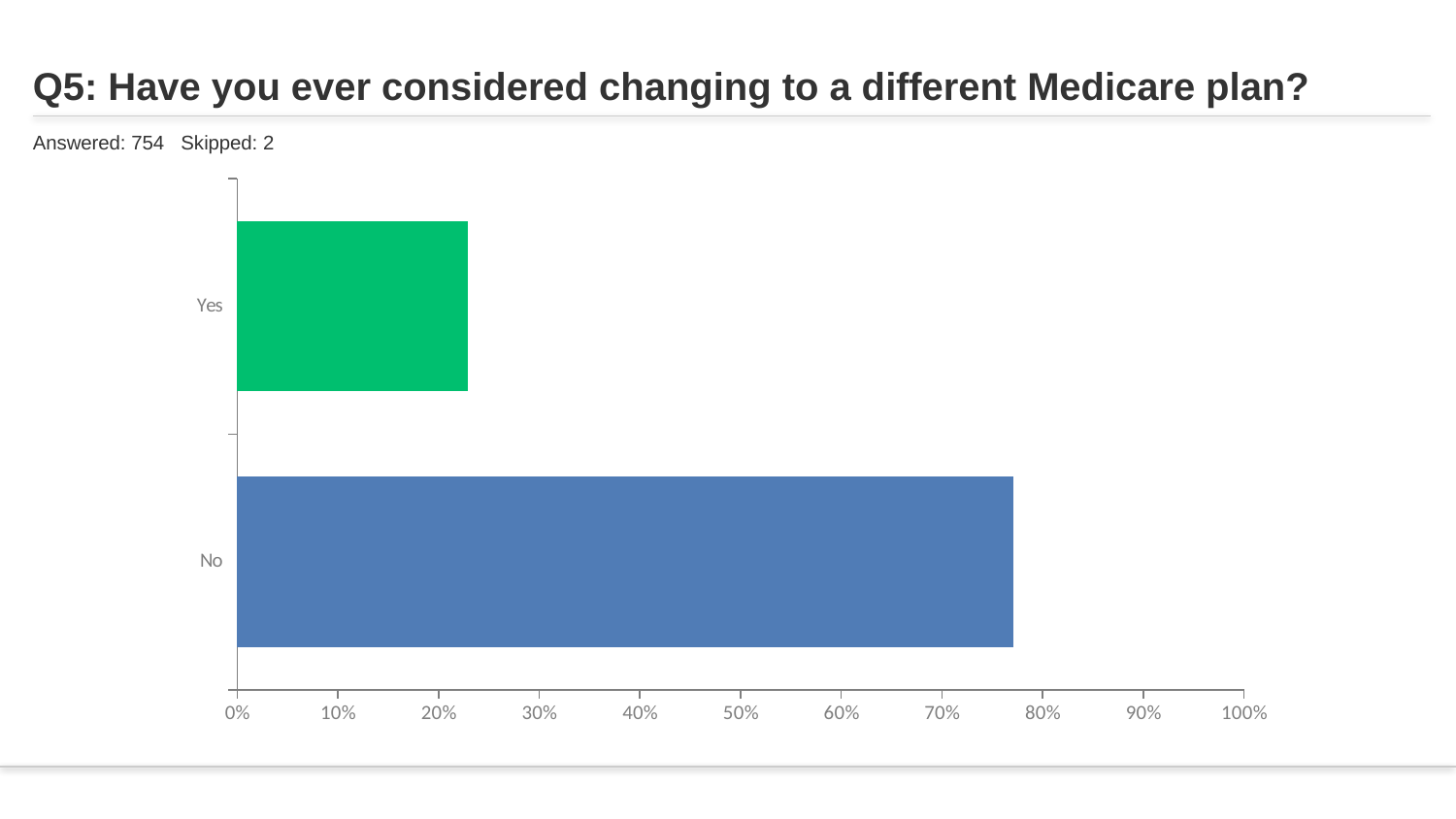
Which category has the highest value? No What kind of chart is shown on the slide? bar chart How many categories does the chart show? 2 Is the value for No greater or less than 70%? greater Is the value for Yes greater or less than 30%? less Is the value for Yes greater or less than 20%? greater Which category has the lowest value? Yes What is the title of the chart? Q5: Have you ever considered changing to a different Medicare plan? Which is larger, the value for Yes or the value for No? No How many respondents answered the question according to the slide? 754